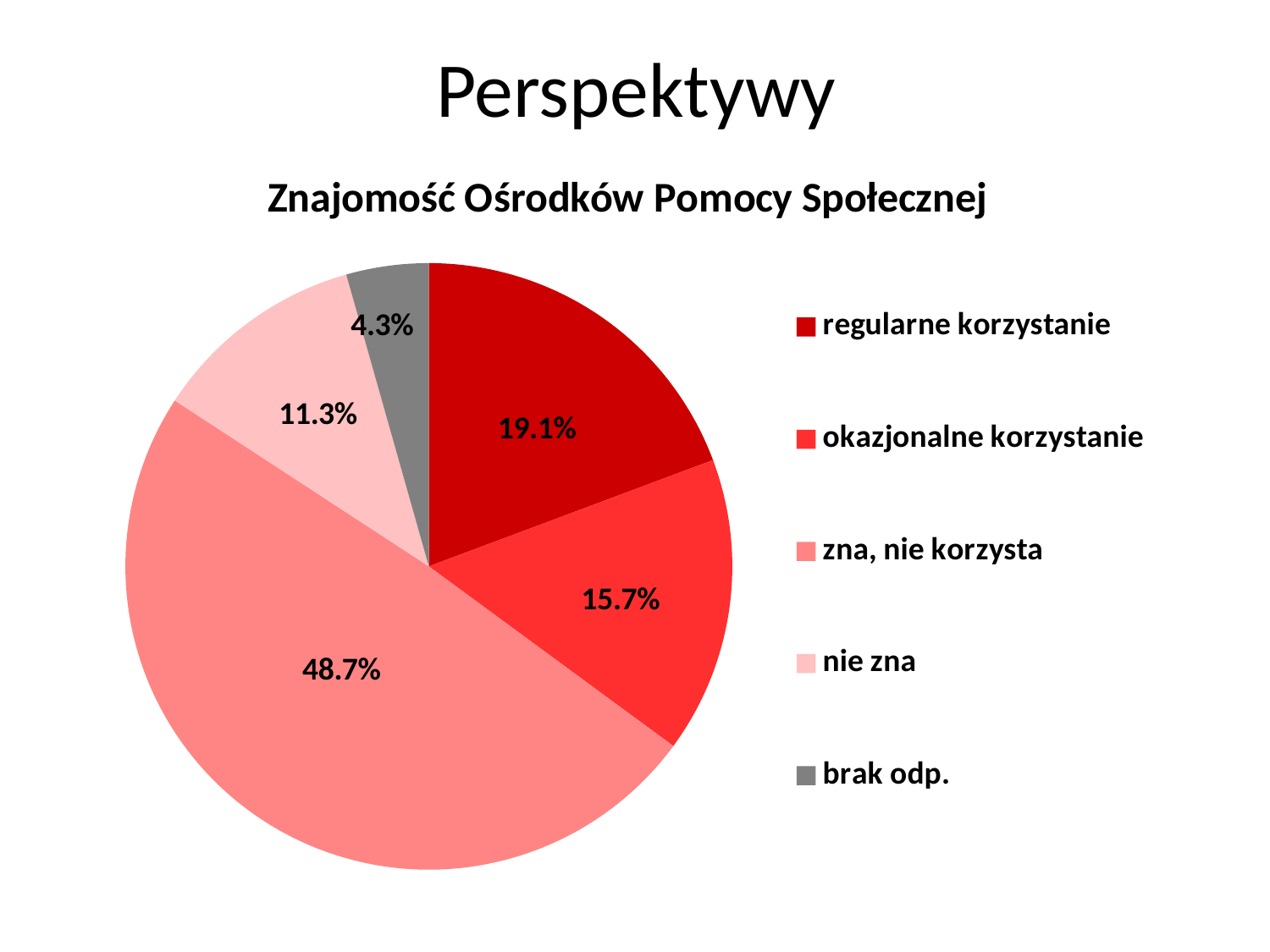
Which category has the smallest slice? brak odp. What kind of chart is shown on the slide? pie chart What is the difference between the shares for 'regularne korzystanie' and 'okazjonalne korzystanie'? 3.4% What share of the pie is 'brak odp.'? 4.3% Which category has the largest slice? zna, nie korzysta What share of the pie is 'okazjonalne korzystanie'? 15.7% What is the title of the chart? Znajomość Ośrodków Pomocy Społecznej What share of the pie is 'nie zna'? 11.3% Which is larger, the share for 'nie zna' or the share for 'okazjonalne korzystanie'? okazjonalne korzystanie How many categories does the pie chart have? 5